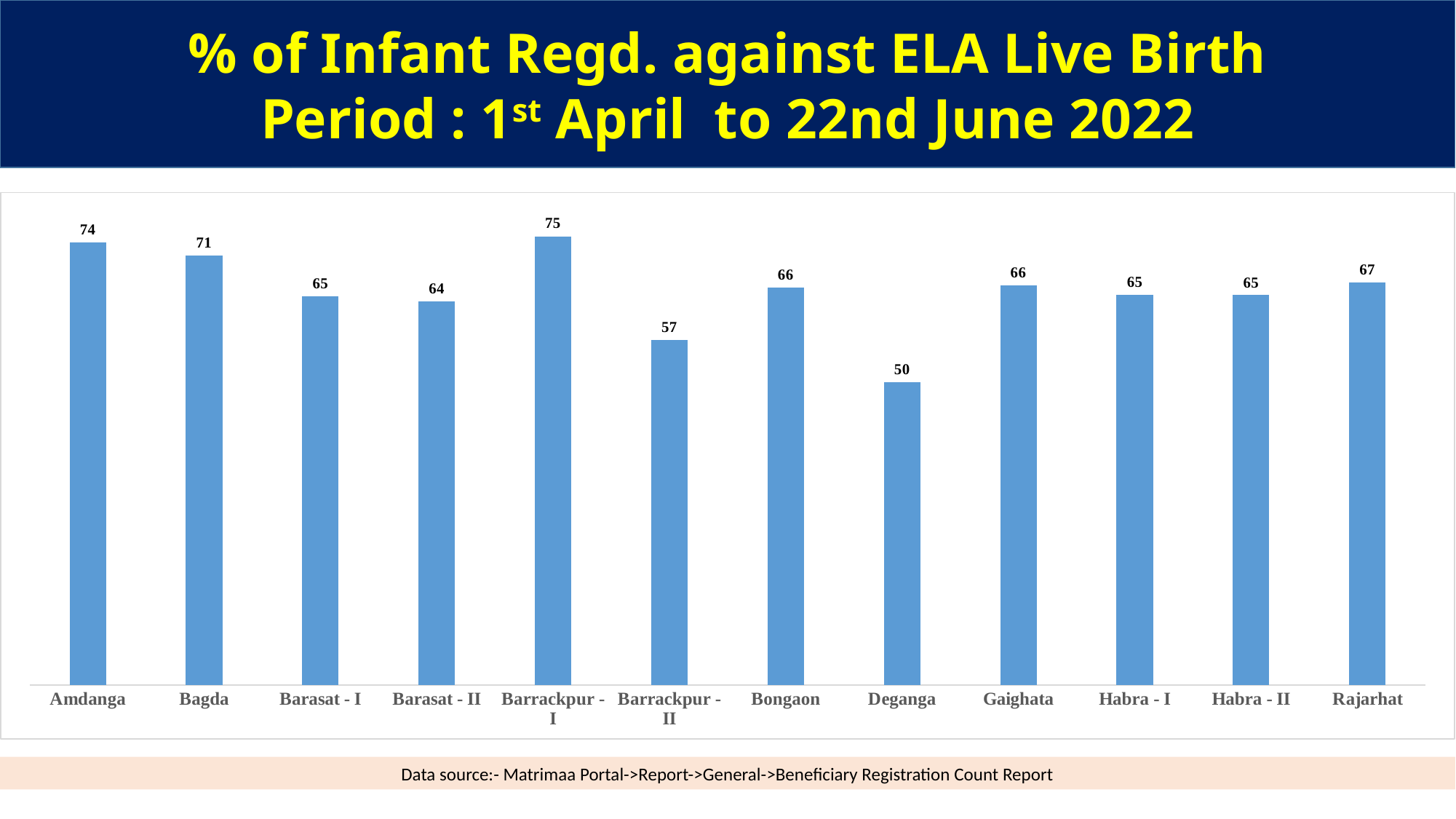
What is the value for Rajarhat? 67 Which block has the lowest value? Deganga What is the difference between the values for Amdanga and Bagda? 3 What is the value for Barrackpur - II? 57 What kind of chart is shown on the slide? Bar chart What is the value for Deganga? 50 What is the value for Amdanga? 74 Which is larger, the value for Bagda or the value for Bongaon? Bagda How many blocks are shown on the chart? 12 Which block has the highest value? Barrackpur - I What is the data source stated at the bottom of the slide? Matrimaa Portal->Report->General->Beneficiary Registration Count Report What is the difference between the values for Barrackpur - I and Deganga? 25